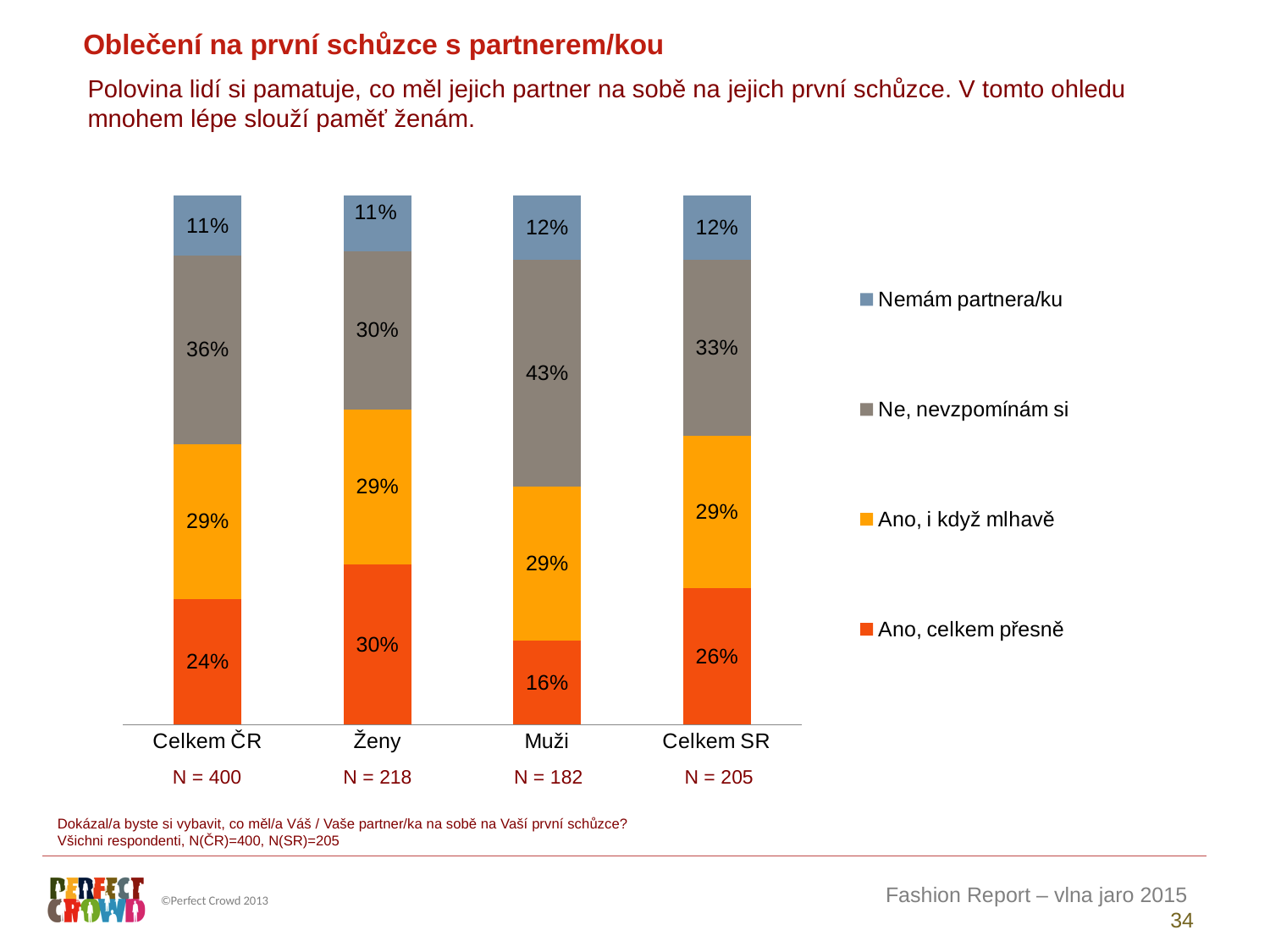
Which category has the lowest value for "Ano, celkem přesně"? Muži Which category has the highest value for "Ne, nevzpomínám si"? Muži What kind of chart is shown on the slide? Stacked bar chart Which is larger: the "Ne, nevzpomínám si" value for Celkem ČR or for Celkem SR? Celkem ČR What is the value for "Ne, nevzpomínám si" in the Ženy bar? 30% What percentage of Muži answered "Ano, celkem přesně"? 16% What is the sample size (N) shown for the Ženy category? N = 218 How many categories are shown on the x axis? 4 What is the difference between the "Ano, celkem přesně" values for Ženy and Muži? 14 percentage points How many series does the legend list? 4 What share of Celkem SR respondents answered "Nemám partnera/ku"? 12% What is the value for "Ano, i když mlhavě" in the Celkem ČR bar? 29%